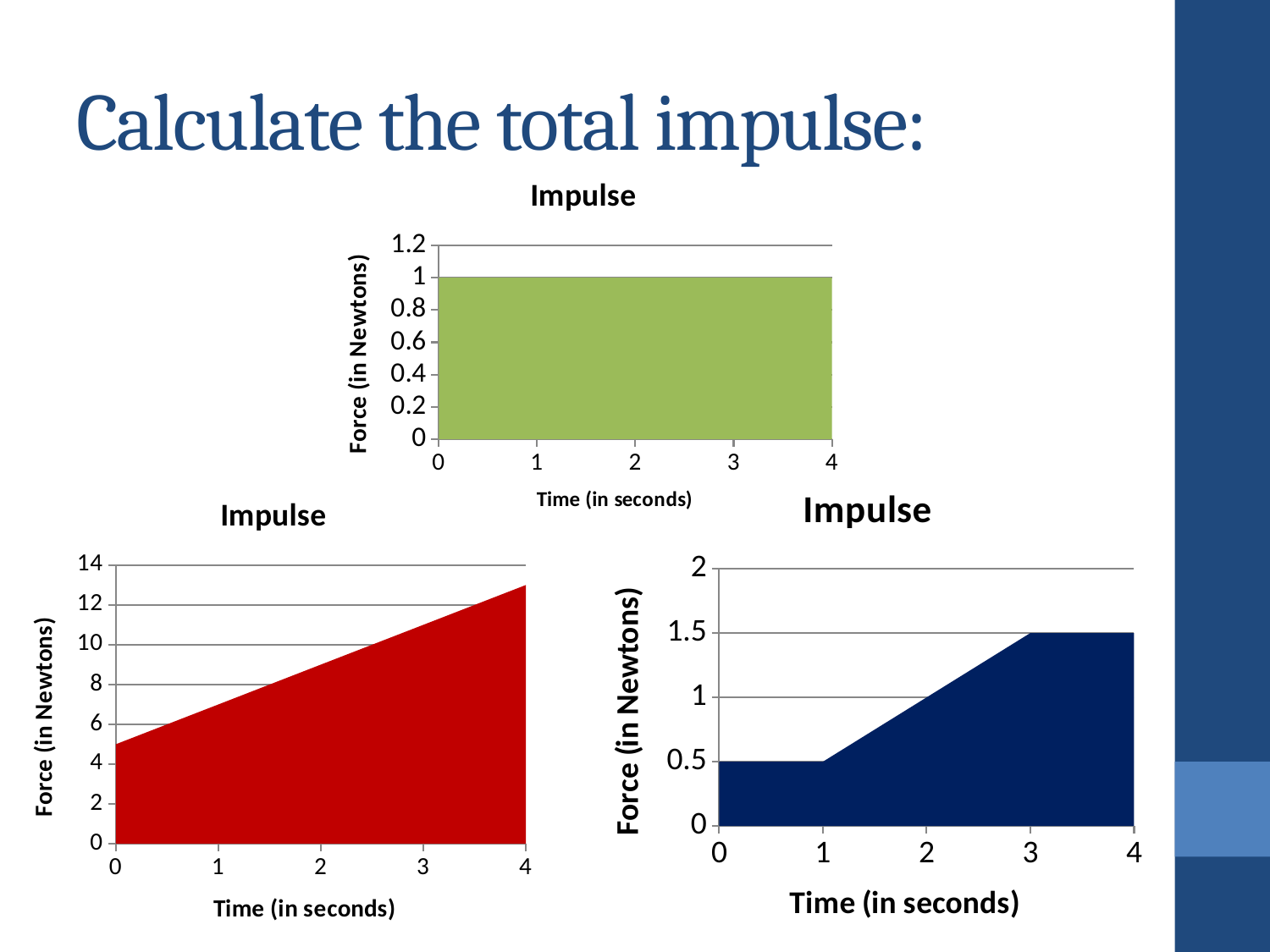
In the bottom-left chart, is the force at time 0 seconds greater or less than 4 Newtons? greater In the bottom-left chart, does the force rise or fall as time increases from 0 to 4 seconds? rises In the bottom-right chart, what is the force (in Newtons) at time 3 seconds? 1.5 In the bottom-left chart, is the force at time 4 seconds greater or less than 12 Newtons? greater In the bottom-right chart, what is the difference between the force at 3 seconds and the force at 1 second? 1 In the top chart, what is the force (in Newtons) at time 2 seconds? 1 What is the title of the bottom-right chart? Impulse In the bottom-right chart, what is the force (in Newtons) at time 0 seconds? 0.5 How many charts are on the slide? 3 In the bottom-right chart, is the force at 4 seconds larger or smaller than the force at 1 second? larger In the top chart, does the force rise, fall or stay constant as time increases from 0 to 4 seconds? stays constant What kind of chart is the top chart on the slide? area chart